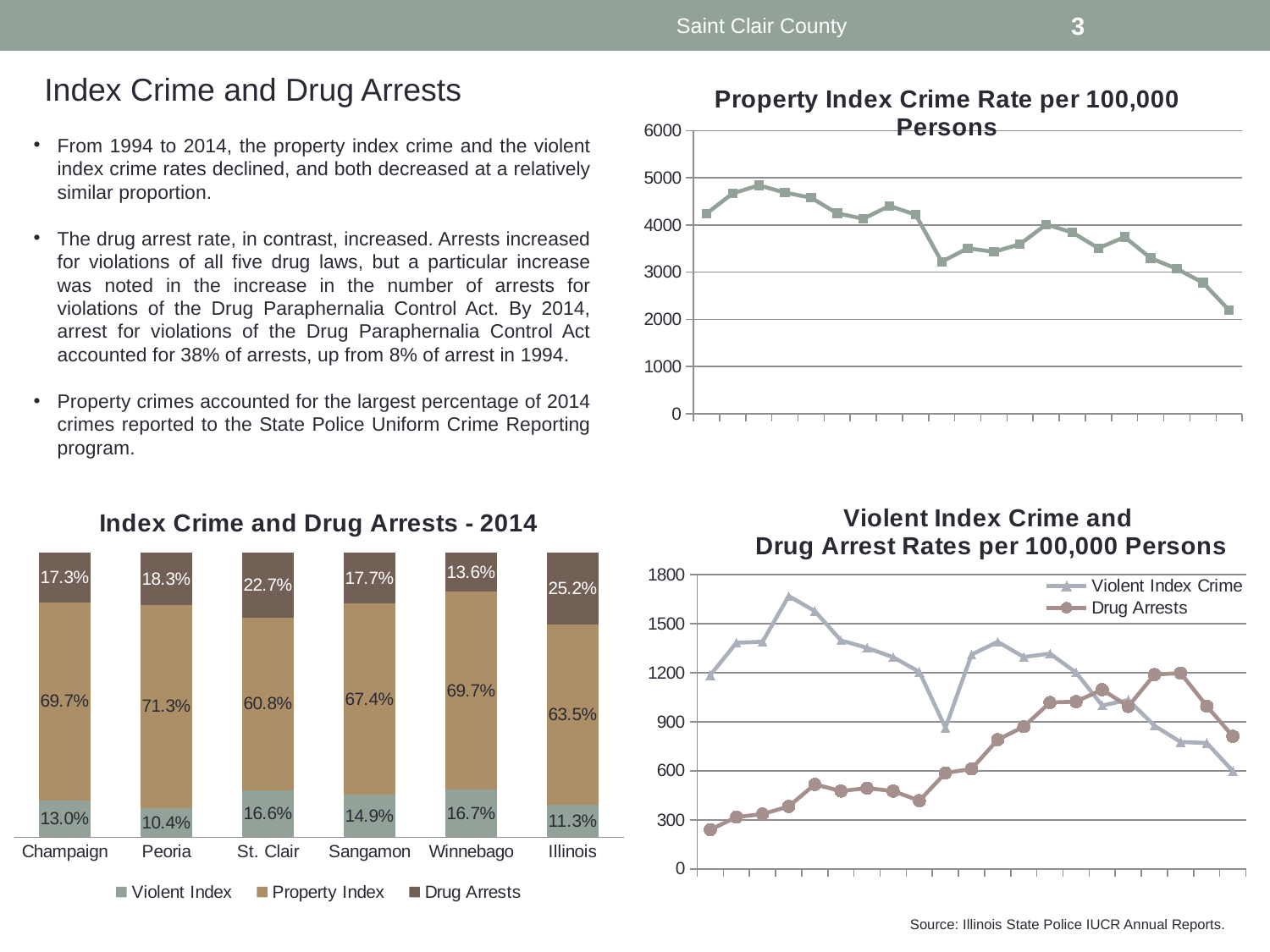
In the 'Index Crime and Drug Arrests - 2014' chart, what is the Drug Arrests value for Illinois? 25.2% In the 'Index Crime and Drug Arrests - 2014' chart, what is the difference between the Drug Arrests values for St. Clair and Champaign? 5.4 percentage points How many categories are shown on the x axis of the 'Index Crime and Drug Arrests - 2014' chart? 6 In the 'Index Crime and Drug Arrests - 2014' chart, which category has the lowest Violent Index value? Peoria In the 'Index Crime and Drug Arrests - 2014' chart, which category has the highest Property Index value? Peoria In the 'Property Index Crime Rate per 100,000 Persons' chart, do the values generally rise or fall from left to right? Fall In the 'Property Index Crime Rate per 100,000 Persons' chart, is the value of the last point greater or less than 3000? less In the 'Index Crime and Drug Arrests - 2014' chart, which is larger: the Violent Index value for Champaign or for Sangamon? Sangamon What kind of chart is 'Index Crime and Drug Arrests - 2014'? Stacked bar chart In the 'Index Crime and Drug Arrests - 2014' chart, what is the Violent Index value for Winnebago? 16.7% How many series does the legend of the 'Index Crime and Drug Arrests - 2014' chart list? 3 In the 'Index Crime and Drug Arrests - 2014' chart, what is the Property Index value for St. Clair? 60.8%